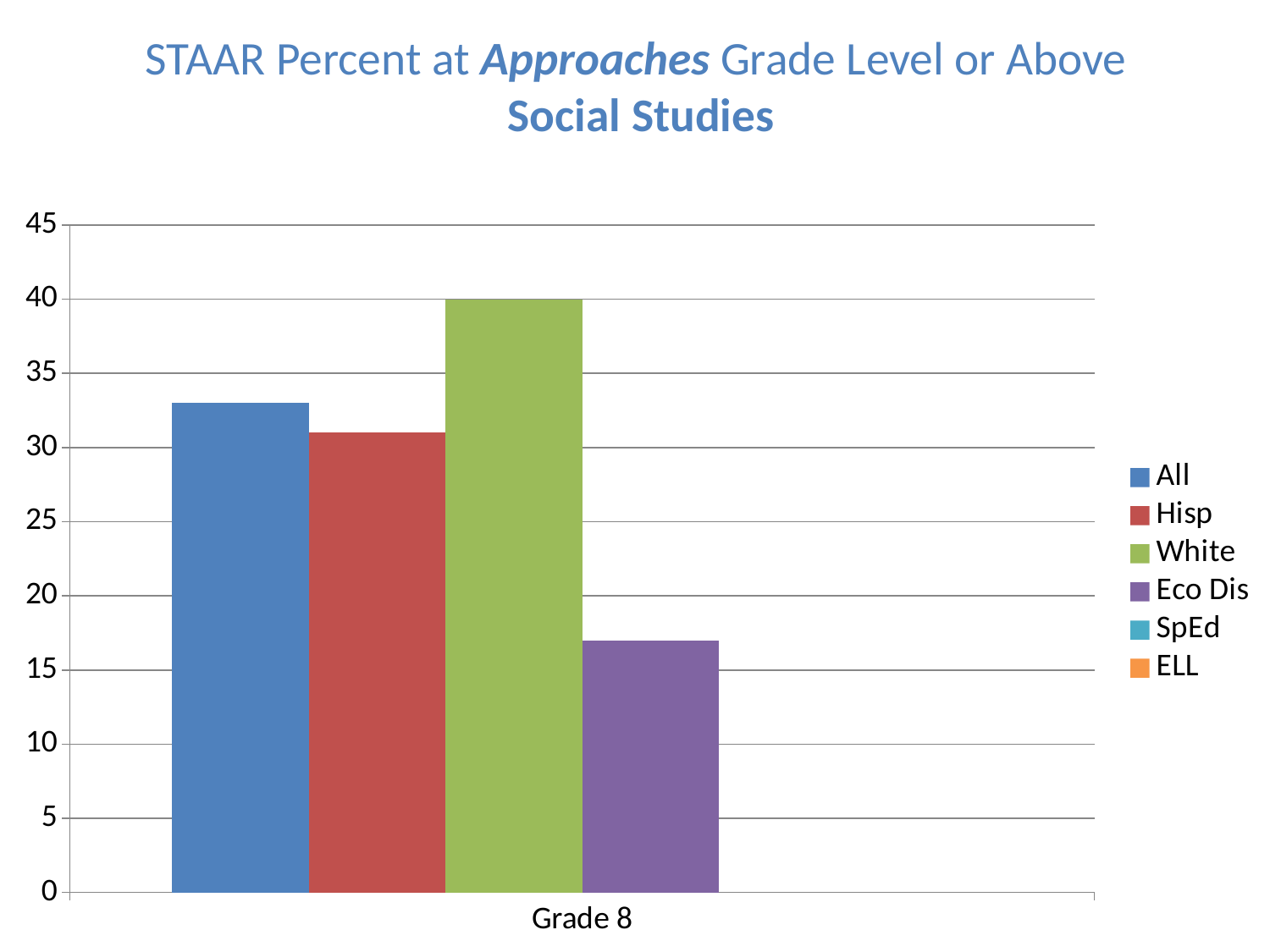
Is the value for Hisp in Grade 8 greater or less than 35? less Which of the plotted series has the lowest value for Grade 8? Eco Dis How many series does the legend list? 6 What is the value for White in Grade 8? 40 What kind of chart is shown on the slide? bar chart Which is larger for Grade 8, the value for All or the value for Eco Dis? All What subject is named in the chart title? Social Studies Which is larger for Grade 8, the value for White or the value for Eco Dis? White Which series has the highest value for Grade 8? White How many categories are shown on the x axis? 1 Is the value for All in Grade 8 greater or less than 30? greater Is the value for Eco Dis in Grade 8 greater or less than 20? less